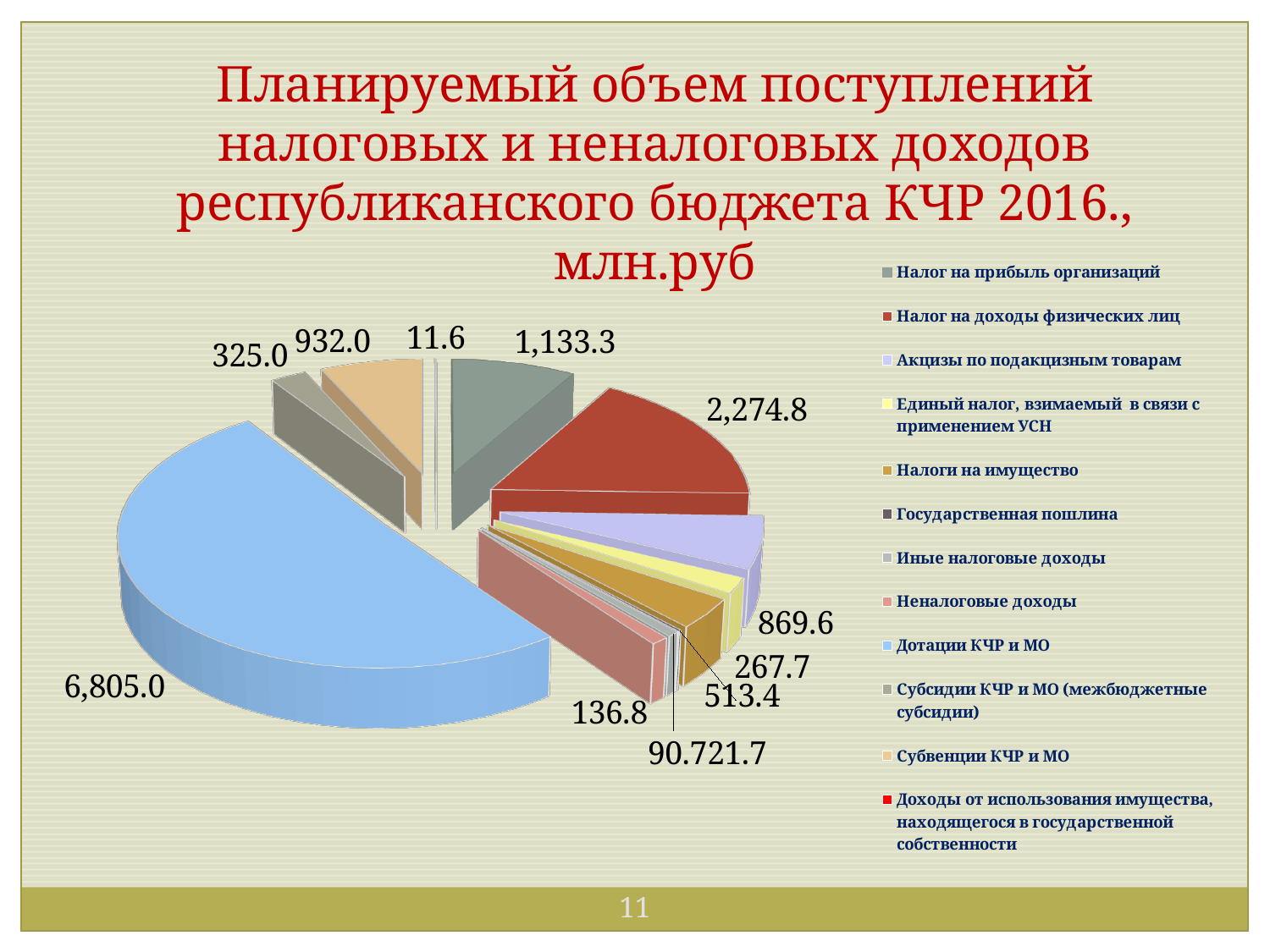
Which category has the largest slice in the pie chart? Дотации КЧР и МО What unit of measurement is stated in the chart title? млн.руб What is the value for Налог на доходы физических лиц? 2,274.8 What is the difference between Налог на доходы физических лиц (2,274.8) and Налог на прибыль организаций (1,133.3)? 1,141.5 Which is larger: Налог на доходы физических лиц or Налог на прибыль организаций? Налог на доходы физических лиц What is the value for Субвенции КЧР и МО? 932.0 What kind of chart is shown on the slide? pie chart What is the value for Налог на прибыль организаций? 1,133.3 What is the value for Акцизы по подакцизным товарам? 869.6 What is the smallest value labelled on the pie chart? 11.6 What is the value of the largest slice, Дотации КЧР и МО? 6,805.0 How many categories does the legend of the pie chart list? 12